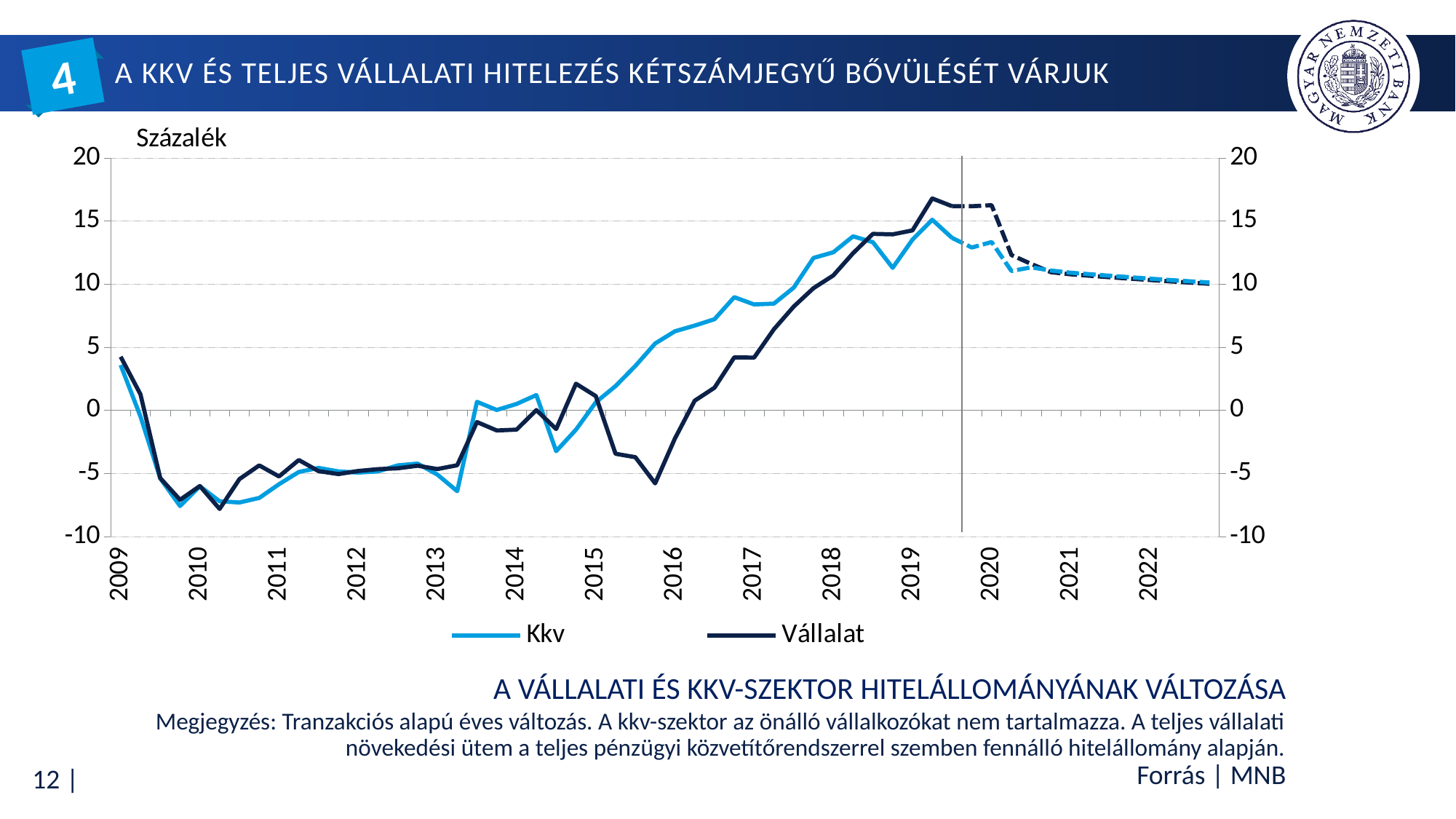
What are the two series named in the legend? Kkv and Vállalat What unit label is shown above the vertical axis? Százalék Is the value of the Kkv series at the start of 2010 greater or less than -5? less Is the value of the Vállalat series at the start of 2017 greater or less than 5? less What kind of chart is shown on the slide? line chart Is the peak value of the Vállalat series in 2019 greater or less than 15? greater At the start of 2016, which series has the larger value, Kkv or Vállalat? Kkv How many year labels are shown on the x axis? 14 Does the Kkv series rise or fall between 2016 and 2019? rise How many series does the legend list? 2